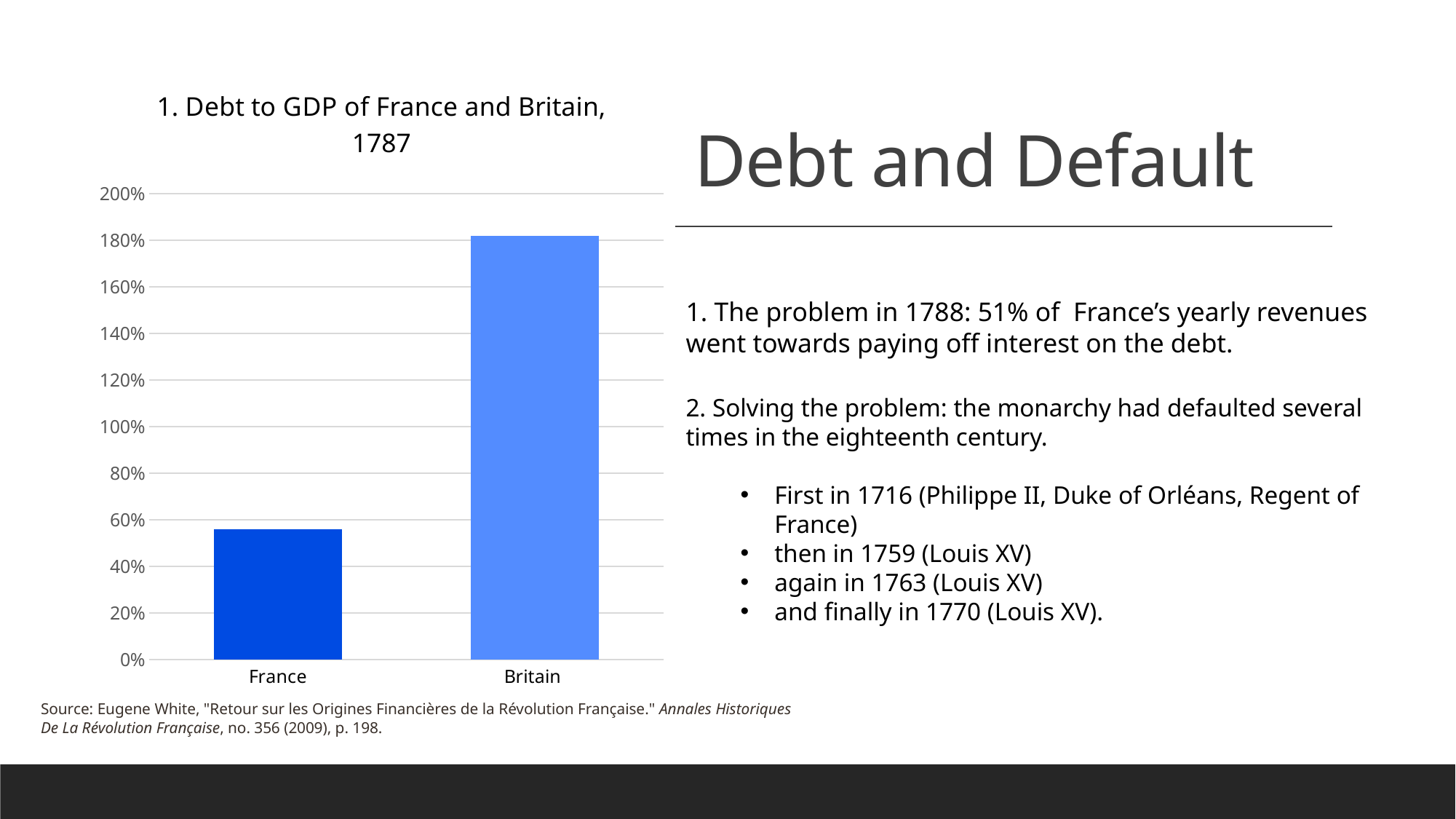
Is the value for Britain greater or less than 200%? less Is the value for France greater or less than 40%? greater What is the title of the chart? 1. Debt to GDP of France and Britain, 1787 What kind of chart is shown on the slide? bar chart What is the highest value shown on the chart's vertical axis? 200% Is the debt to GDP value for France larger or smaller than the value for Britain? smaller Is the value for Britain greater or less than 160%? greater Which country has the lower debt to GDP ratio in the chart? France How many countries are shown in the chart? 2 Which country has the higher debt to GDP ratio in the chart? Britain